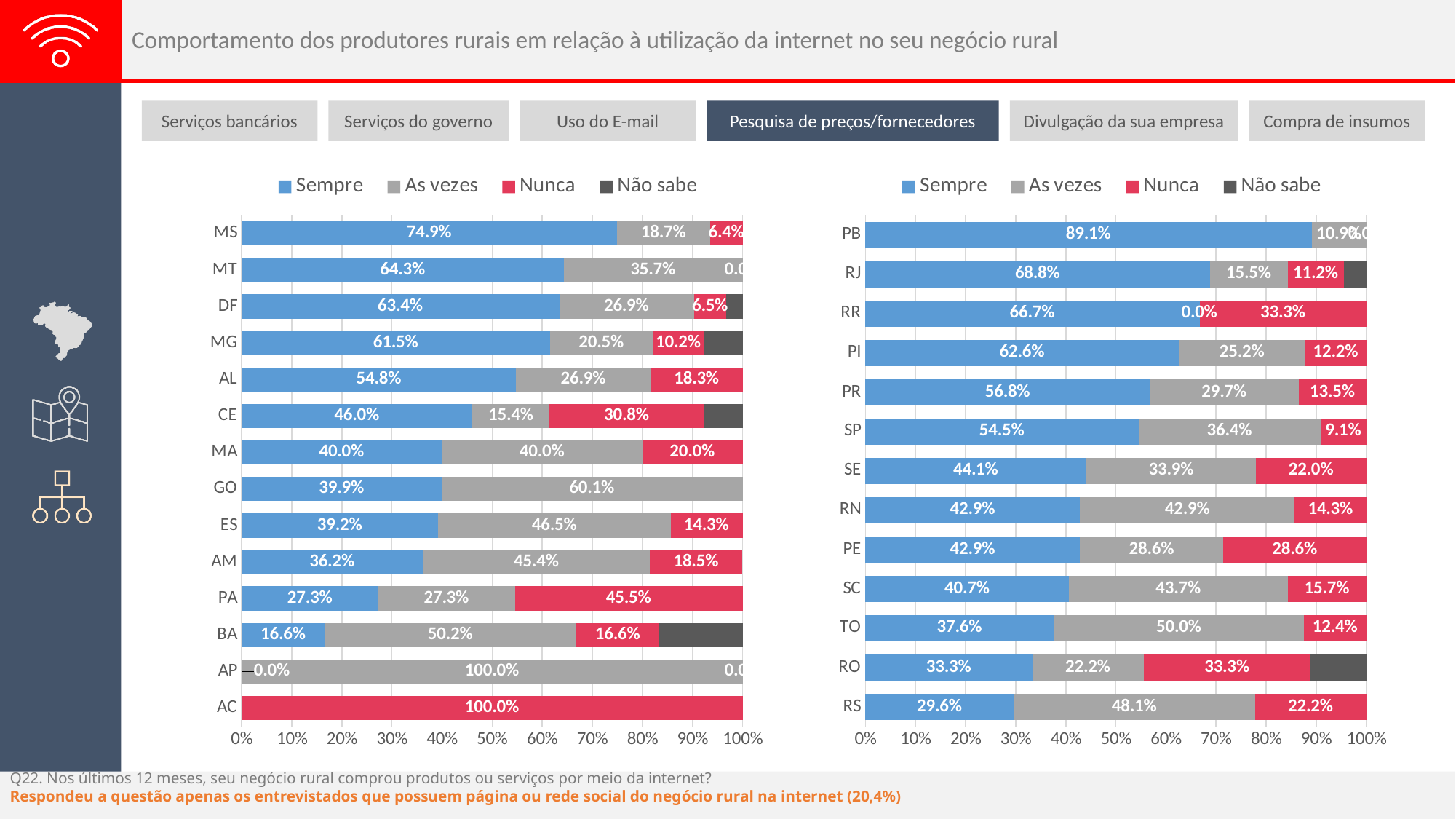
What kind of chart is the left chart? Stacked bar chart In the left chart, what is the difference between the 'Sempre' values for MS and MT? 10.6% How many categories are shown in the right chart? 13 In the right chart, what is the 'As vezes' value for TO? 50.0% In the left chart, which category has the highest 'Sempre' value? MS In the left chart, what is the 'Sempre' value for MS? 74.9% In the right chart, what is the 'Sempre' value for PB? 89.1% In the left chart, what is the 'Nunca' value for PA? 45.5% In the right chart, which category has the lowest 'Sempre' value? RS How many series does the legend of the right chart list? 4 How many categories are shown in the left chart? 14 In the right chart, which is larger, the 'Nunca' value for RR or for PI? RR